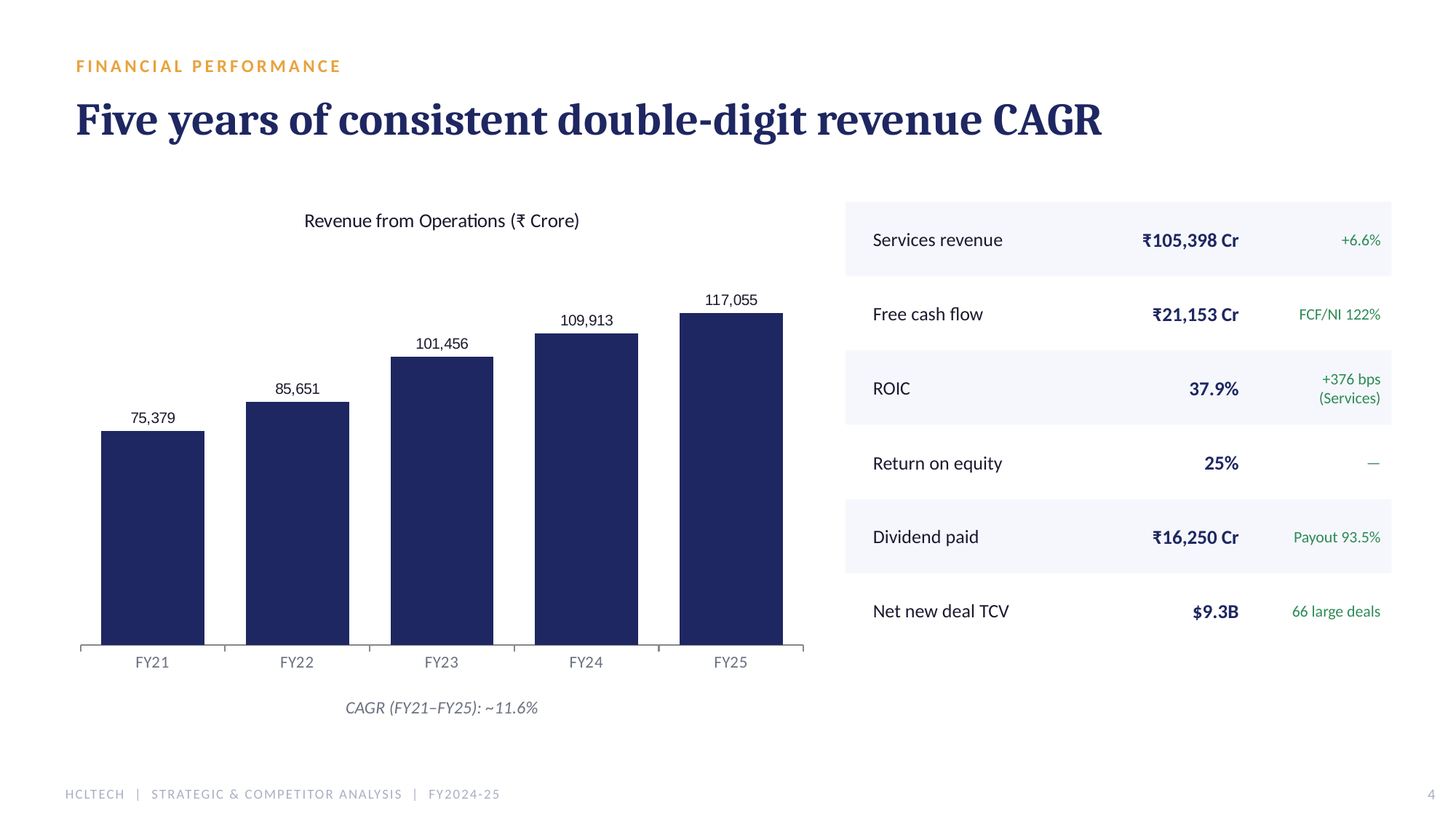
What is the revenue from operations for FY25? 117,055 Which year has higher revenue from operations, FY22 or FY23? FY23 What is the difference in revenue from operations between FY25 and FY24? 7,142 What type of chart is used to show revenue from operations? Bar chart What is the difference in revenue from operations between FY22 and FY21? 10,272 Does revenue from operations rise or fall from FY21 to FY25? Rise What is the title of the chart? Revenue from Operations (₹ Crore) What is the revenue from operations for FY23? 101,456 How many fiscal years are shown in the chart? 5 Which fiscal year has the highest revenue from operations? FY25 What is the revenue from operations for FY21? 75,379 Which fiscal year has the lowest revenue from operations? FY21